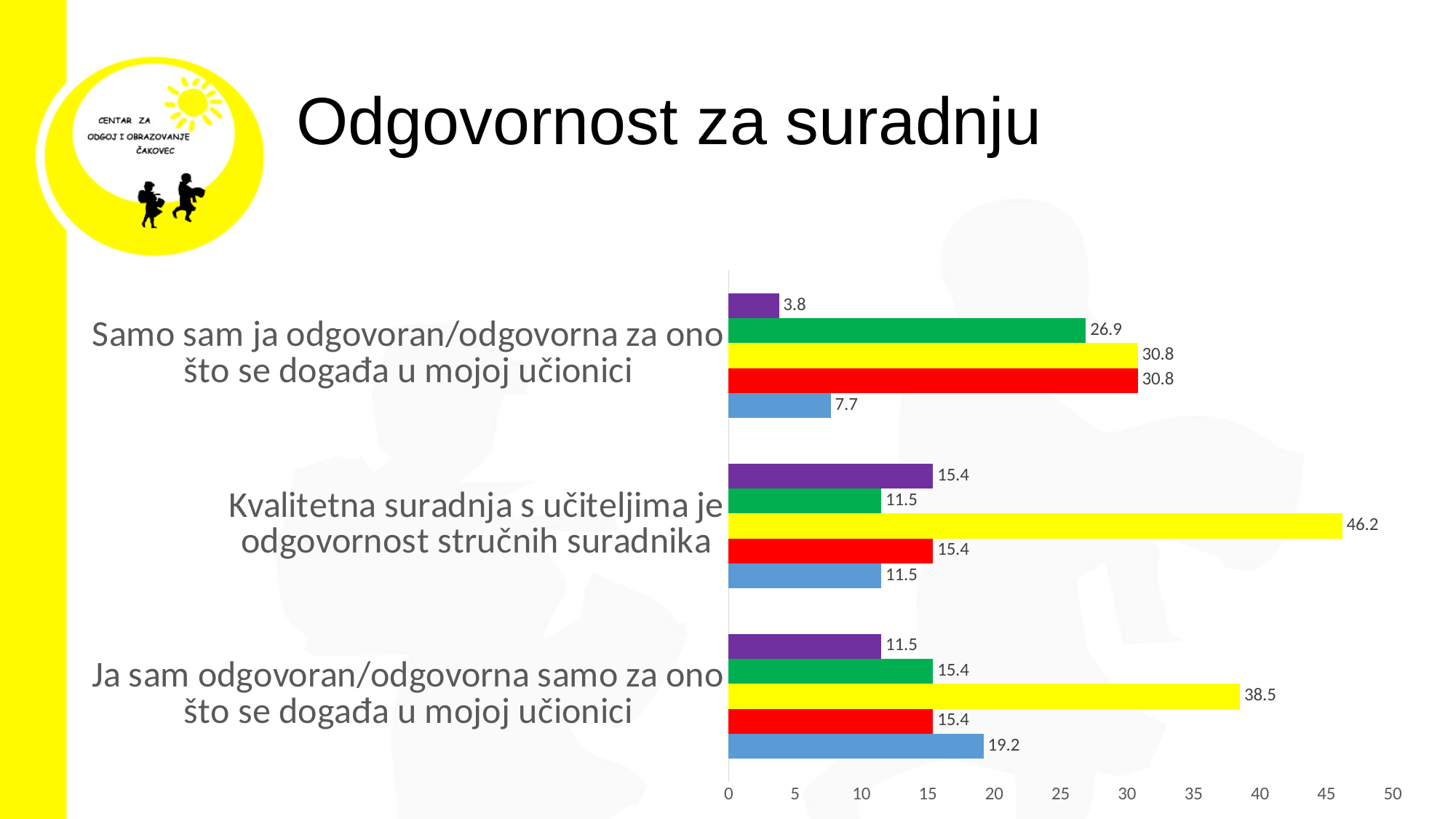
What is the value of the purple bar for "Samo sam ja odgovoran/odgovorna za ono što se događa u mojoj učionici"? 3.8 What is the value of the yellow bar for "Kvalitetna suradnja s učiteljima je odgovornost stručnih suradnika"? 46.2 For "Ja sam odgovoran/odgovorna samo za ono što se događa u mojoj učionici", which is larger, the blue bar or the red bar? blue bar What type of chart is shown on the slide? bar chart What is the difference between the green bar and the blue bar for "Samo sam ja odgovoran/odgovorna za ono što se događa u mojoj učionici"? 19.2 How many categories are shown on the vertical axis of the chart? 3 What is the title of the slide? Odgovornost za suradnju What is the difference between the yellow bar and the green bar for "Kvalitetna suradnja s učiteljima je odgovornost stručnih suradnika"? 34.7 Which coloured bar is the lowest for "Samo sam ja odgovoran/odgovorna za ono što se događa u mojoj učionici"? purple What is the value of the blue bar for "Ja sam odgovoran/odgovorna samo za ono što se događa u mojoj učionici"? 19.2 Is the value of the yellow bar for "Ja sam odgovoran/odgovorna samo za ono što se događa u mojoj učionici" greater or less than 35? greater Which category has the highest yellow bar? Kvalitetna suradnja s učiteljima je odgovornost stručnih suradnika